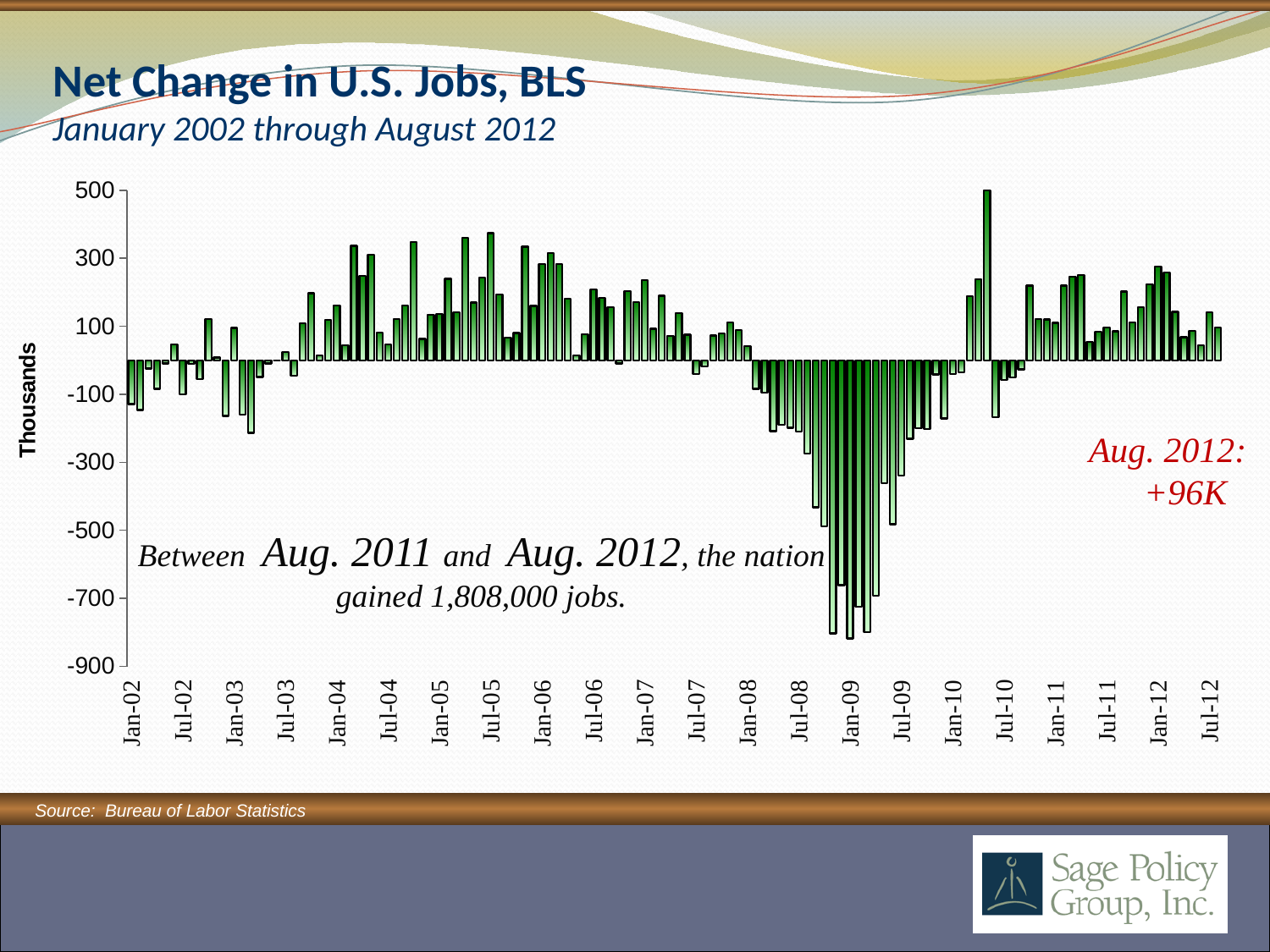
According to the text on the chart, how many jobs did the nation gain between Aug. 2011 and Aug. 2012? 1,808,000 What is the title of the chart? Net Change in U.S. Jobs, BLS Is the value for Jan-09 greater or less than -700? less Do the monthly values rise or fall between Jan-08 and Jan-09? fall Which is larger, the value for Jan-12 or the value for Jan-09? Jan-12 Around which period does the chart show its lowest (most negative) monthly values? Around Jan-09 According to the annotation on the chart, what was the net change in U.S. jobs in August 2012? +96K Is the value for Jan-12 greater or less than 100? greater Is the value for Jan-02 greater or less than 0? less What kind of chart is shown on the slide? bar chart What is the lowest tick value shown on the vertical axis? -900 What is the label on the vertical axis of the chart? Thousands